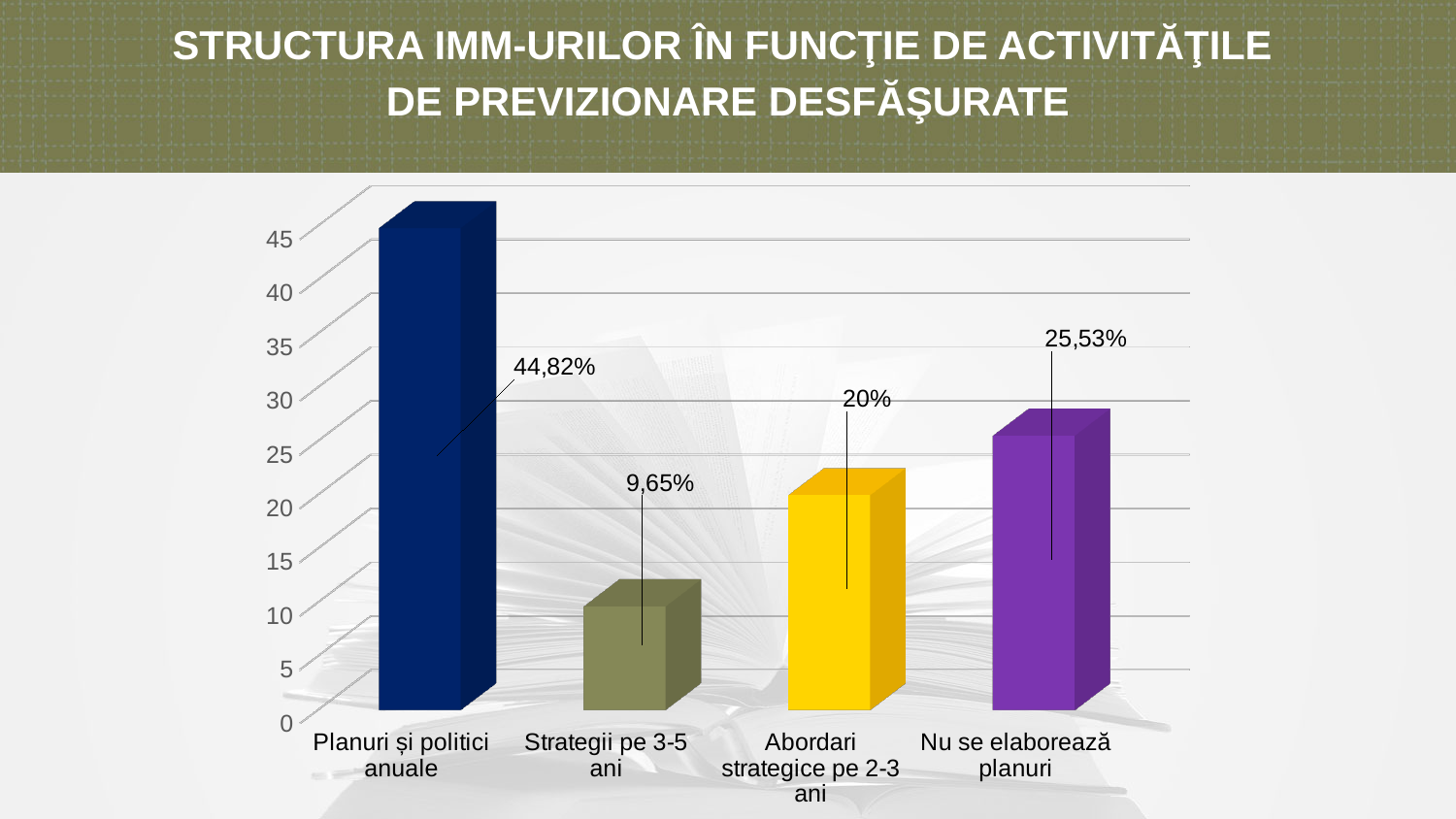
What is the difference between the values for "Planuri și politici anuale" and "Strategii pe 3-5 ani"? 35,17% What kind of chart is shown on the slide? Bar chart Which category has the lowest value? Strategii pe 3-5 ani Which is larger: the value for "Nu se elaborează planuri" or the value for "Abordari strategice pe 2-3 ani"? Nu se elaborează planuri What is the value for "Strategii pe 3-5 ani"? 9,65% What is the value for "Planuri și politici anuale"? 44,82% What is the difference between the values for "Nu se elaborează planuri" and "Abordari strategice pe 2-3 ani"? 5,53% What is the title of the slide? STRUCTURA IMM-URILOR ÎN FUNCŢIE DE ACTIVITĂŢILE DE PREVIZIONARE DESFĂŞURATE Which category has the highest value? Planuri și politici anuale What is the value for "Nu se elaborează planuri"? 25,53% How many categories are shown on the chart? 4 What is the value for "Abordari strategice pe 2-3 ani"? 20%